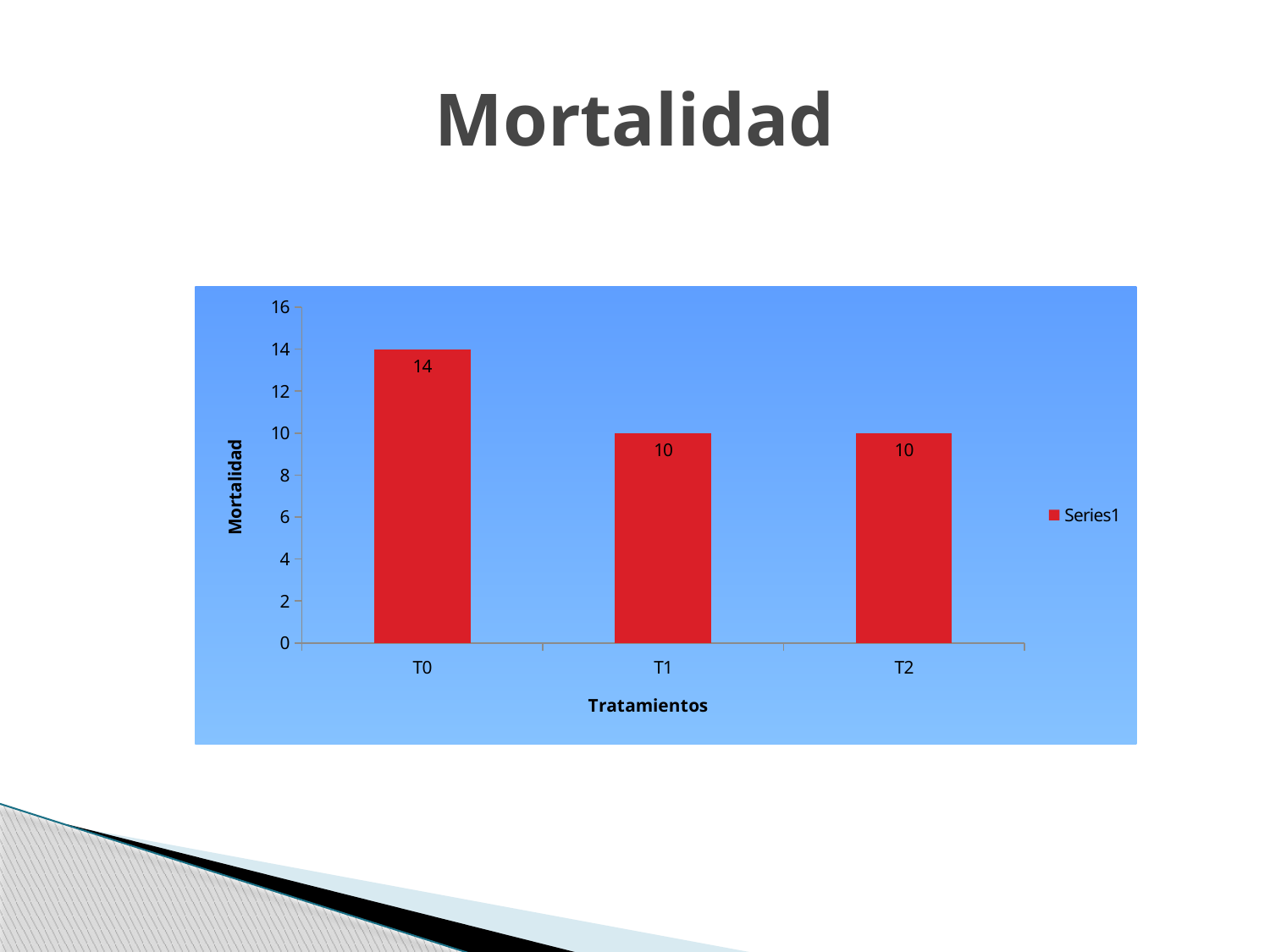
Which treatment has the highest mortality? T0 Is the value for T0 greater or less than 12? greater What is the label of the y axis? Mortalidad What is the label of the x axis? Tratamientos What kind of chart is shown? bar chart What is the value for T1? 10 How many treatments are shown on the x axis? 3 What is the value for T0? 14 How many series does the legend list? 1 Which is larger, the value for T0 or the value for T2? T0 What is the difference between the values for T0 and T1? 4 What is the value for T2? 10